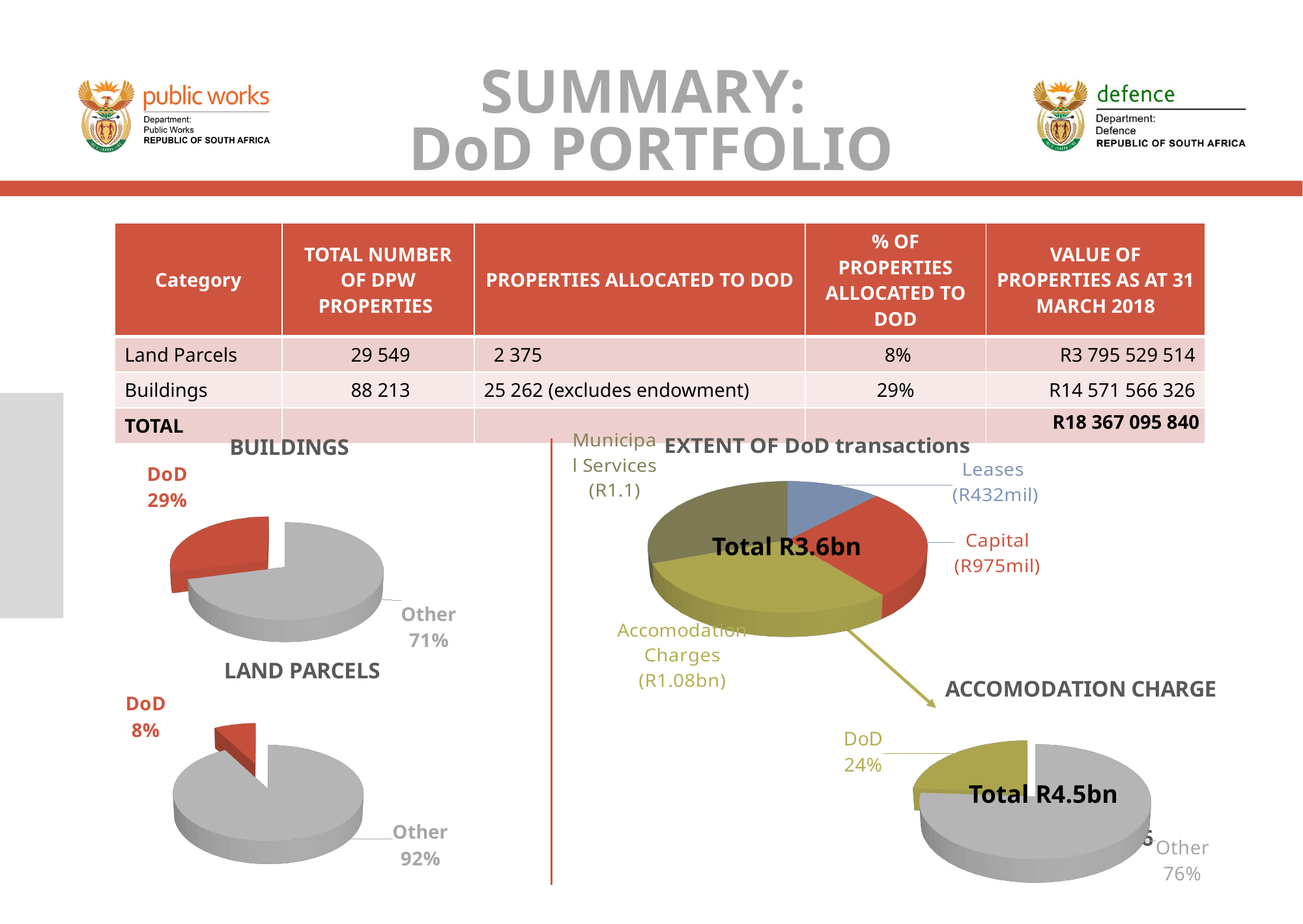
What total is printed on the ACCOMODATION CHARGE pie chart? Total R4.5bn What kind of chart is the BUILDINGS chart? Pie chart In the LAND PARCELS pie chart, what share is labelled for Other? 92% In the EXTENT OF DoD transactions chart, which category has the smallest slice? Leases In the ACCOMODATION CHARGE pie chart, how many percentage points larger is Other than DoD? 52 In the EXTENT OF DoD transactions chart, what value is labelled for Leases? R432mil In the BUILDINGS pie chart, what share is labelled for DoD? 29% In the EXTENT OF DoD transactions chart, how many slices does the pie have? 4 In the ACCOMODATION CHARGE pie chart, what share is labelled for DoD? 24% What total is printed on the EXTENT OF DoD transactions pie chart? Total R3.6bn In the EXTENT OF DoD transactions chart, what value is labelled for Capital? R975mil Which chart shows a larger DoD share, BUILDINGS or LAND PARCELS? BUILDINGS